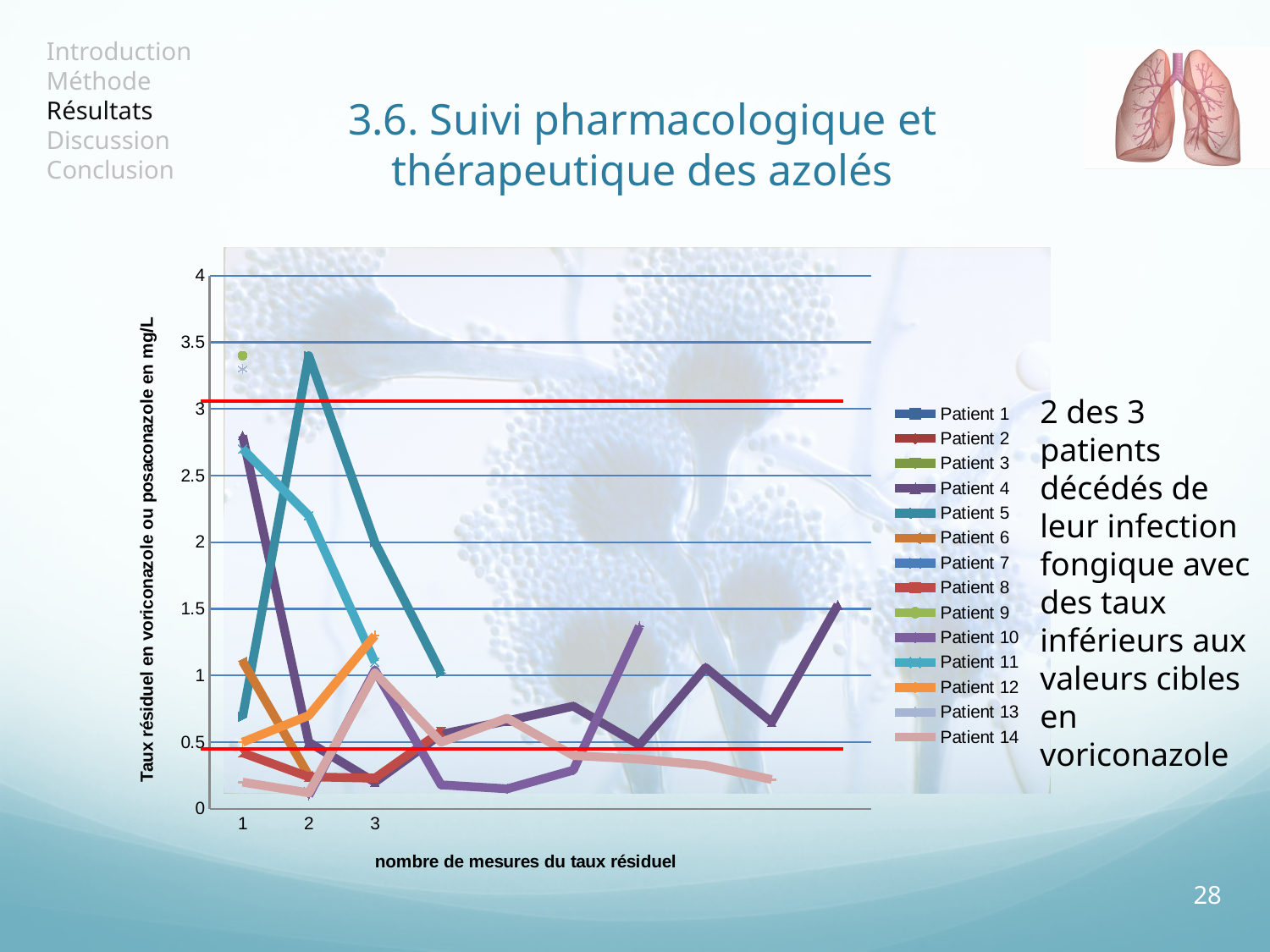
How many series does the legend list? 14 At measure 2, which is larger: the value for Patient 5 or the value for Patient 11? Patient 5 What is the title of the x axis? nombre de mesures du taux résiduel What is the title of the y axis? Taux résiduel en voriconazole ou posaconazole en mg/L Is the value for Patient 11 at measure 1 greater or less than 2.5? greater Is the value for Patient 12 at measure 3 greater or less than 1? greater What kind of chart is shown on the slide? line chart Is the value for Patient 14 at measure 1 greater or less than 0.5? less Does the value for Patient 11 rise or fall from measure 1 to measure 3? fall Does the value for Patient 5 rise or fall from measure 1 to measure 2? rise